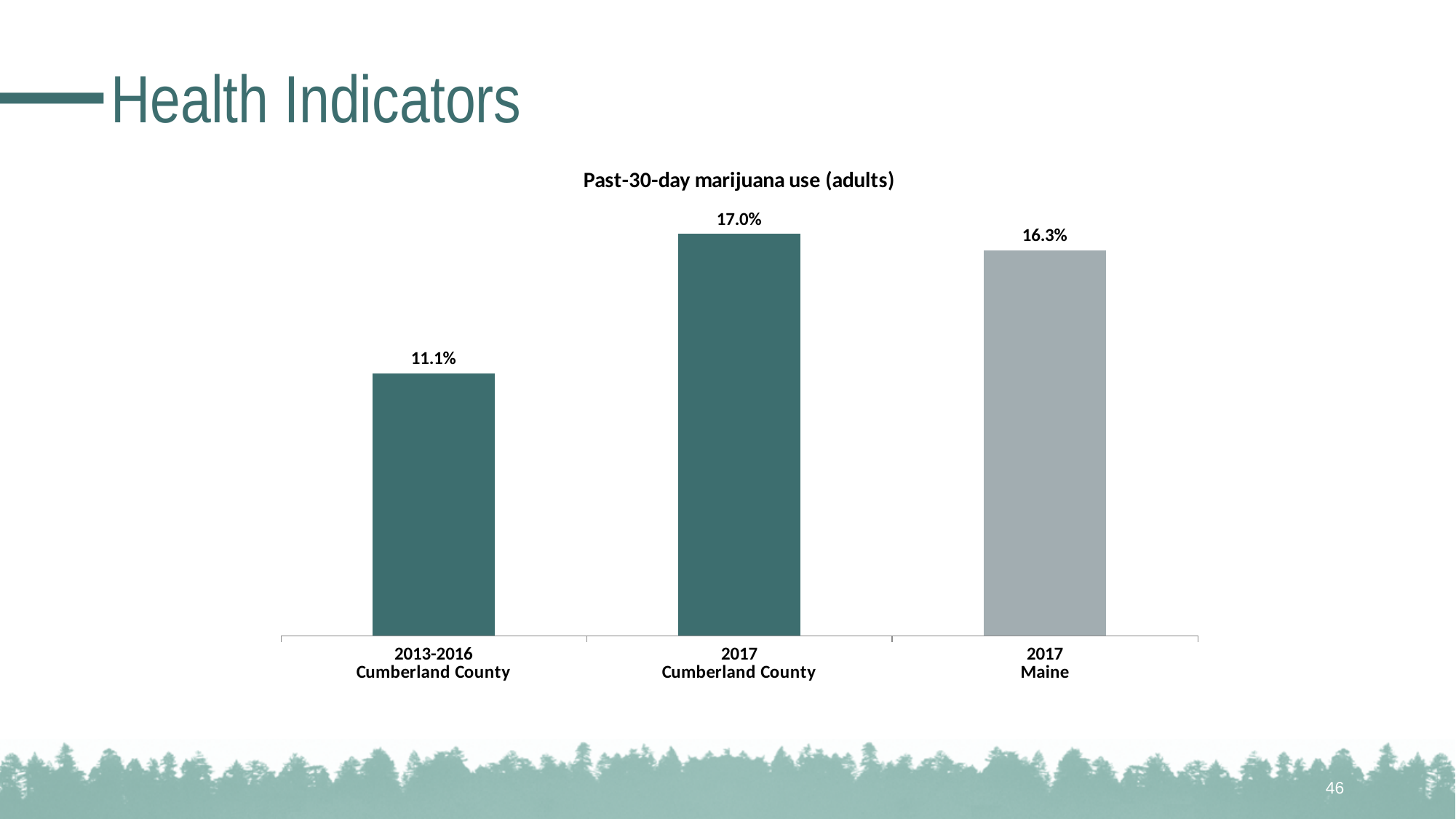
What is the title of the chart? Past-30-day marijuana use (adults) What is the past-30-day marijuana use value for 2017 Maine? 16.3% What is the difference between the 2017 Cumberland County value and the 2013-2016 Cumberland County value? 5.9% How many bars are shown in the chart? 3 Which is larger, the 2013-2016 Cumberland County value or the 2017 Maine value? 2017 Maine What is the past-30-day marijuana use value for 2013-2016 Cumberland County? 11.1% What kind of chart is shown on the slide? Bar chart Which bar is shown in a lighter grey colour than the others? 2017 Maine What is the difference between the 2017 Cumberland County value and the 2017 Maine value? 0.7% Which category has the highest past-30-day marijuana use value? 2017 Cumberland County What is the past-30-day marijuana use value for 2017 Cumberland County? 17.0% Which category has the lowest past-30-day marijuana use value? 2013-2016 Cumberland County